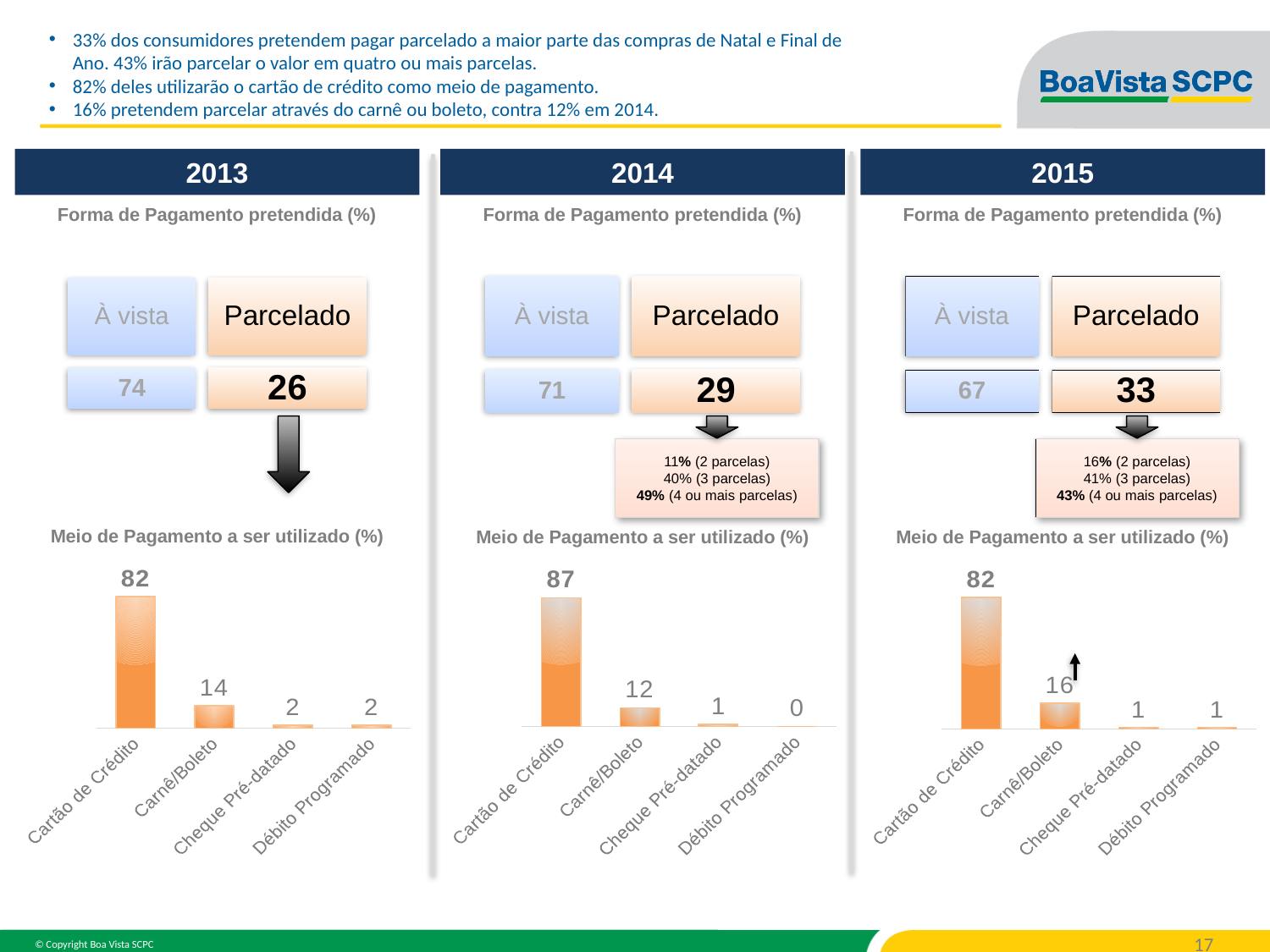
How many categories are shown in the 2015 'Meio de Pagamento a ser utilizado (%)' chart? 4 In the 2014 'Meio de Pagamento a ser utilizado (%)' chart, which category has the lowest value? Débito Programado In the 2014 'Meio de Pagamento a ser utilizado (%)' chart, what is the value for Carnê/Boleto? 12 In the 2013 'Meio de Pagamento a ser utilizado (%)' chart, what is the difference between Cartão de Crédito and Carnê/Boleto? 68 Comparing the 2013 and 2014 'Meio de Pagamento a ser utilizado (%)' charts, which year has the larger value for Cartão de Crédito? 2014 In the 2014 'Meio de Pagamento a ser utilizado (%)' chart, which category has the highest value? Cartão de Crédito What type of chart is the 2013 'Meio de Pagamento a ser utilizado (%)' chart? Bar chart In the 2015 'Meio de Pagamento a ser utilizado (%)' chart, what is the difference between Cartão de Crédito and Carnê/Boleto? 66 In the 2013 'Meio de Pagamento a ser utilizado (%)' chart, what is the value for Cartão de Crédito? 82 In the 2015 'Meio de Pagamento a ser utilizado (%)' chart, what is the value for Cheque Pré-datado? 1 In the 2015 'Meio de Pagamento a ser utilizado (%)' chart, what is the value for Carnê/Boleto? 16 In the 2014 'Meio de Pagamento a ser utilizado (%)' chart, what is the value for Débito Programado? 0